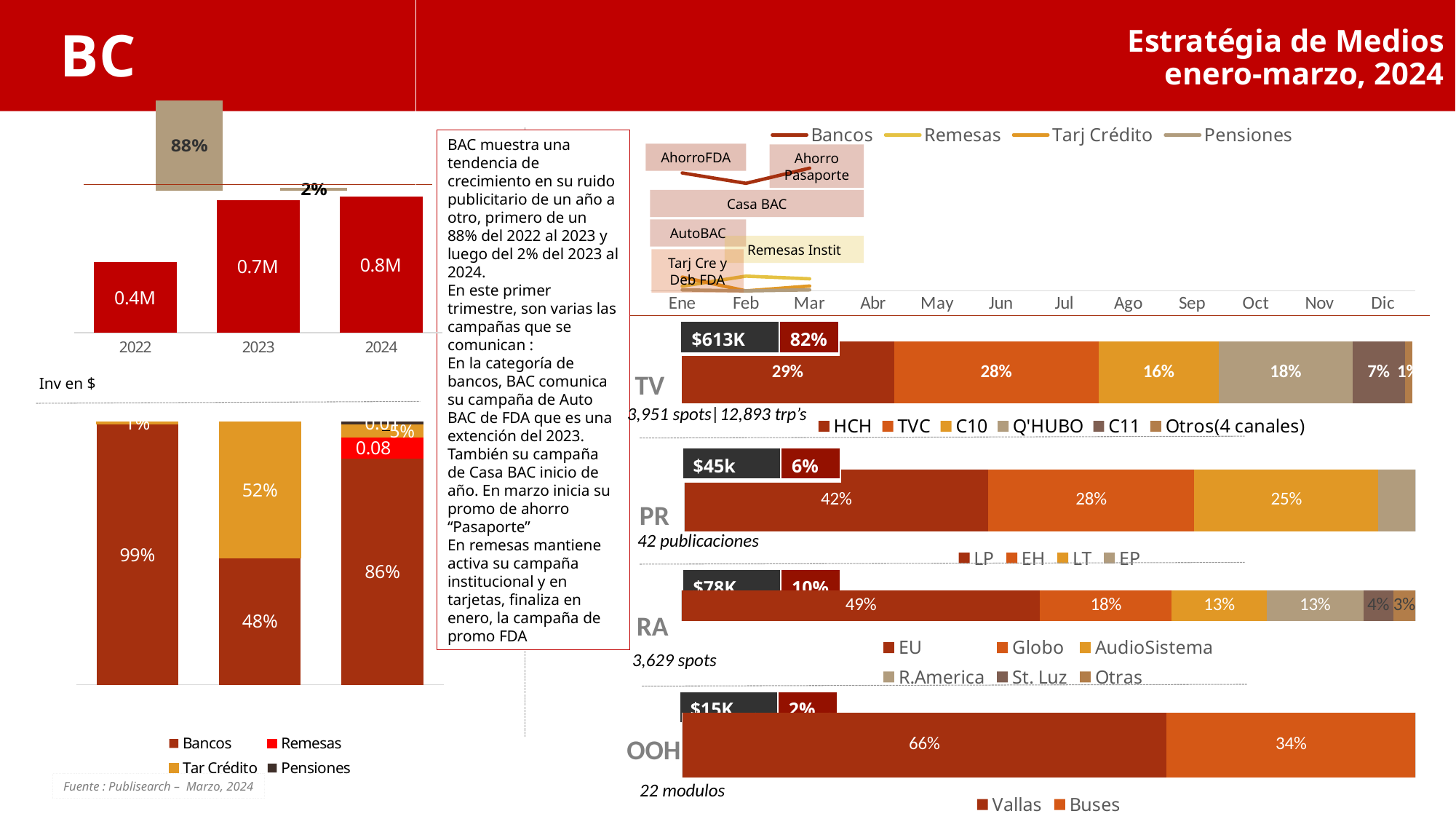
In the 'Inv en $' bar chart on the left, what is the value for 2024? 0.8M In the OOH bar on the right, what share do Buses have? 34% In the TV bar on the right, what share does HCH have? 29% In the stacked bar chart at the bottom left, what is the Bancos share for 2024? 86% In the 'Inv en $' bar chart on the left, which year has the lowest value? 2022 In the 'Inv en $' bar chart on the left, how many years are shown? 3 In the PR bar on the right, what is the difference between the LP share and the LT share? 17% In the 'Inv en $' bar chart on the left, do the values rise or fall from 2022 to 2024? rise In the stacked bar chart at the bottom left, what is the Tar Crédito share for 2023? 52% In the TV bar on the right, which channel has the largest share? HCH In the RA bar on the right, which is larger, the share for EU or the share for Globo? EU In the stacked bar chart at the bottom left, how many series does the legend list? 4